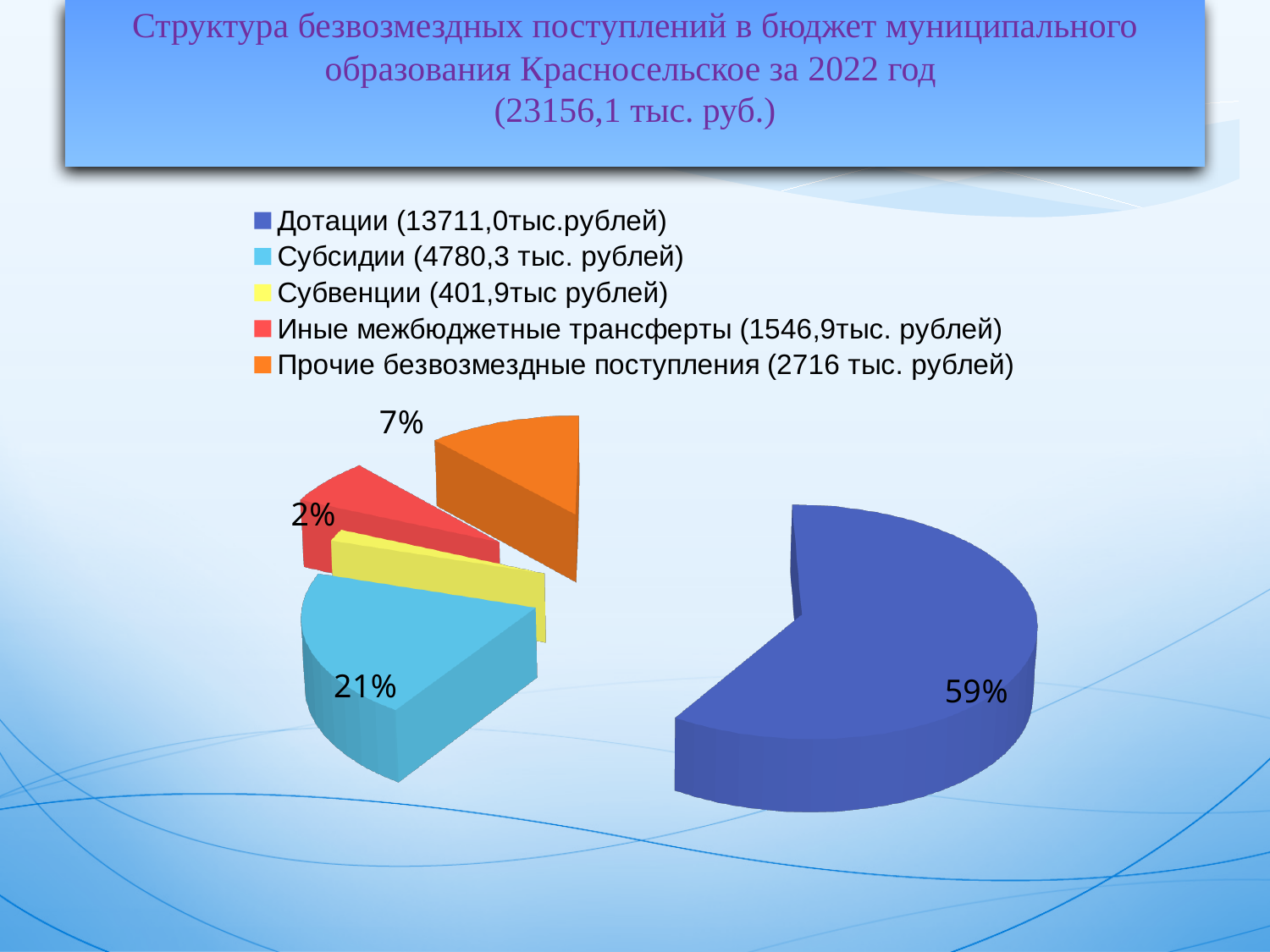
Which category has the largest share of the pie? Дотации What percentage share of the pie does Дотации have? 59% What value is given in the legend for Иные межбюджетные трансферты? 1546,9 тыс. рублей What value is given in the legend for Субсидии? 4780,3 тыс. рублей What value is given in the legend for Дотации? 13711,0 тыс. рублей What value is given in the legend for Субвенции? 401,9 тыс. рублей What value is given in the legend for Прочие безвозмездные поступления? 2716 тыс. рублей Which is larger, Субсидии or Прочие безвозмездные поступления? Субсидии What kind of chart is shown on the slide? Pie chart What percentage share of the pie does Субсидии have? 21% Which category has the smallest share of the pie? Субвенции How many slices does the pie chart have? 5